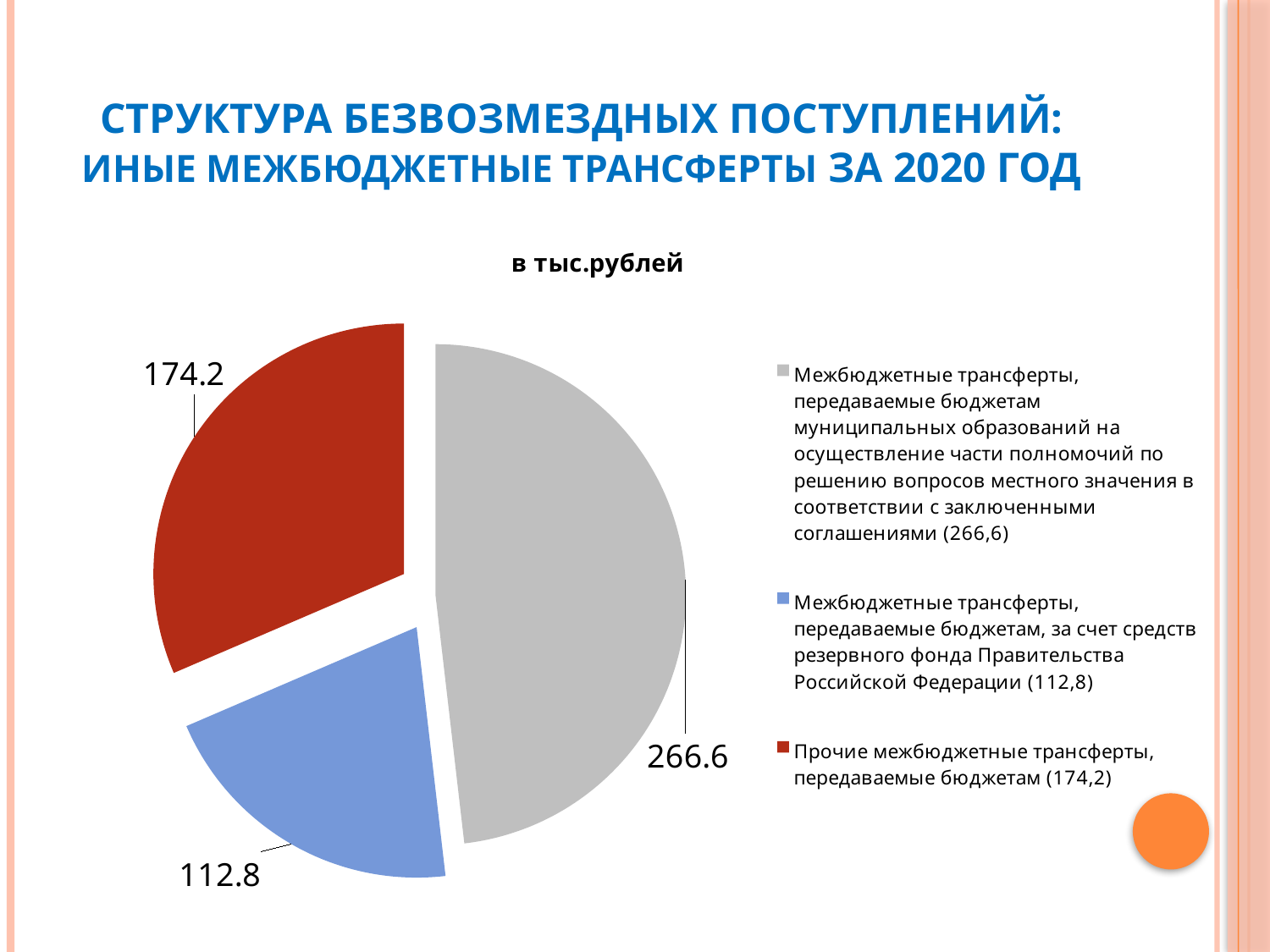
How many slices does the pie chart have? 3 What unit is stated in the chart title above the pie? в тыс.рублей What type of chart is shown on the slide? Pie chart What is the value of the smallest slice in the pie chart? 112.8 What value is shown for the slice 'Прочие межбюджетные трансферты, передаваемые бюджетам'? 174.2 Which slice is larger: the red one (174.2) or the blue one (112.8)? The red one (174.2) What is the total of all three slices in the pie chart? 553.6 What is the difference between the slice labelled 174.2 and the slice labelled 112.8? 61.4 What is the value of the largest slice in the pie chart? 266.6 How many entries does the legend list? 3 What value is shown for the slice 'Межбюджетные трансферты, передаваемые бюджетам, за счет средств резервного фонда Правительства Российской Федерации'? 112.8 What is the difference between the largest slice (266.6) and the smallest slice (112.8)? 153.8